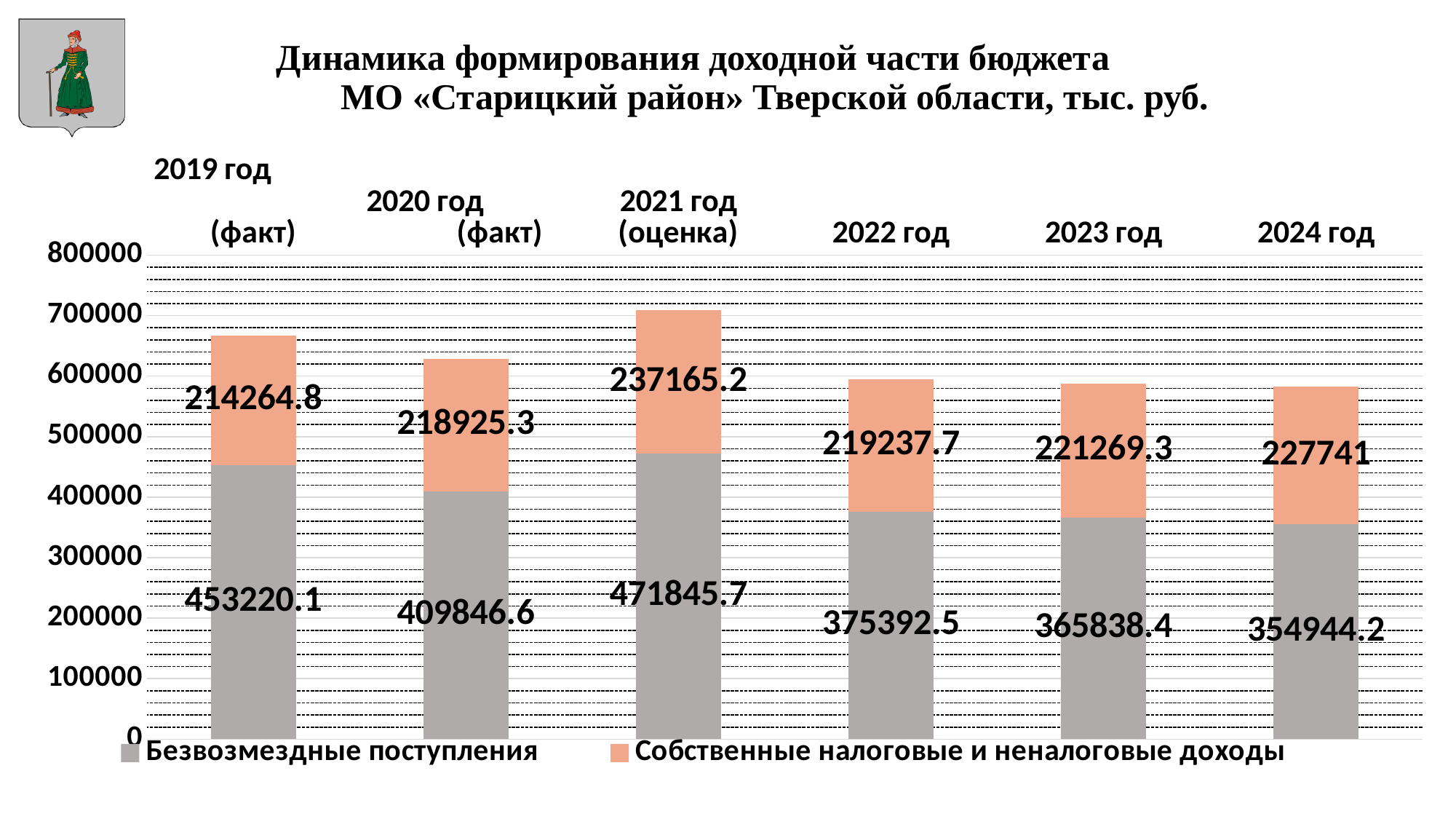
In which year is Безвозмездные поступления the lowest? 2024 год What is the value of Безвозмездные поступления for 2019 год (факт)? 453220.1 Which is larger: Собственные налоговые и неналоговые доходы in 2023 год or in 2022 год? 2023 год What is the difference between Безвозмездные поступления in 2019 год (факт) and in 2024 год? 98275.9 What is the value of Собственные налоговые и неналоговые доходы for 2021 год (оценка)? 237165.2 How many year categories are shown on the x axis? 6 What type of chart is shown on the slide? Stacked bar chart How many series does the legend list? 2 What is the total of the stacked bar for 2019 год (факт)? 667484.9 Is the total of the stacked bar for 2024 год greater or less than 600000? less In which year is Безвозмездные поступления the highest? 2021 год (оценка) What is the value of Собственные налоговые и неналоговые доходы for 2024 год? 227741